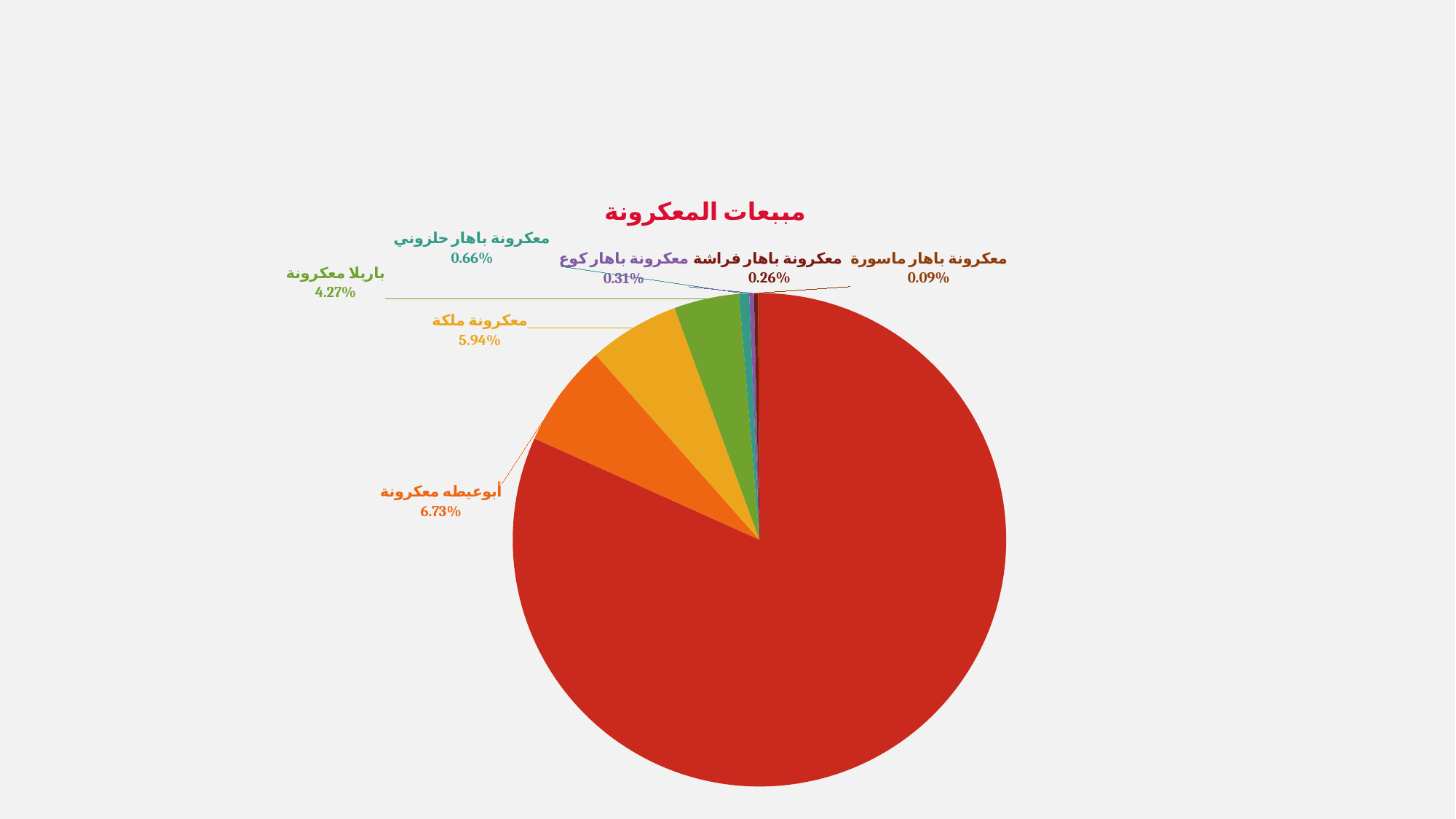
What colour is the slice for أبوعيطه معكرونة? orange Which of the labeled slices has the largest share? أبوعيطه معكرونة Which has a larger share, باريلا معكرونة or معكرونة ملكة? معكرونة ملكة What is the title of the chart? مببعات المعكرونة What type of chart is shown on the slide? pie chart What share of the pie does باريلا معكرونة have? 4.27% What share of the pie does معكرونة باهار ماسورة have? 0.09% What share of the pie does أبوعيطه معكرونة have? 6.73% Which of the labeled slices has the smallest share? معكرونة باهار ماسورة What share of the pie does معكرونة باهار حلزوني have? 0.66% What is the difference between the shares of أبوعيطه معكرونة and معكرونة ملكة? 0.79% What share of the pie does معكرونة ملكة have? 5.94%